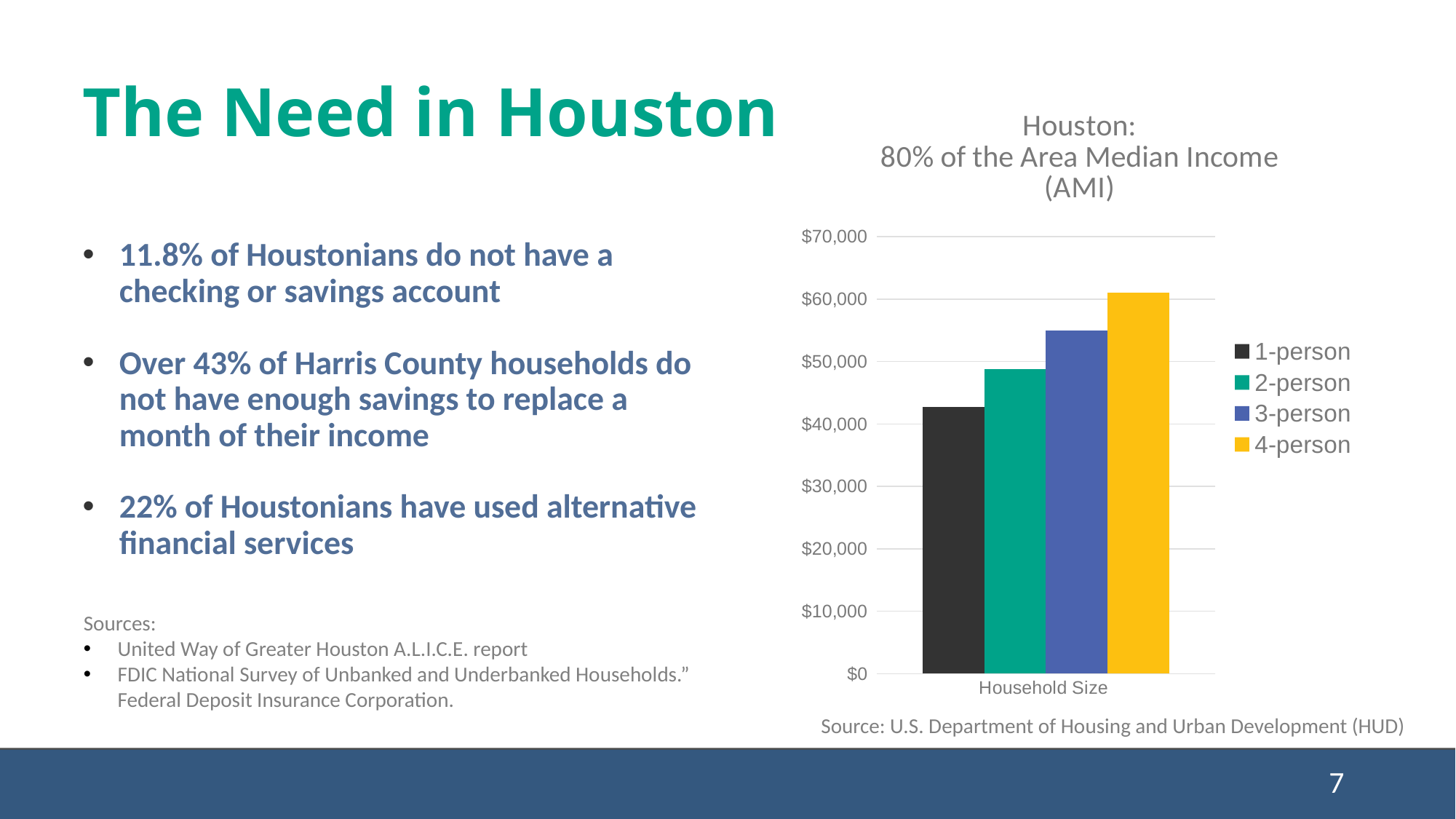
Do the values rise or fall as household size increases from 1-person to 4-person? rise What colour represents the 4-person series in the chart? yellow Is the value for 1-person households greater or less than $50,000? less Which household size has the highest value in the chart? 4-person What is the title of the chart? Houston: 80% of the Area Median Income (AMI) How many series does the chart legend list? 4 Which is larger, the value for 3-person or the value for 2-person households? 3-person What kind of chart is shown on the slide? bar chart Is the value for 3-person households greater or less than $60,000? less Which household size has the lowest value in the chart? 1-person Is the value for 4-person households greater or less than $70,000? less